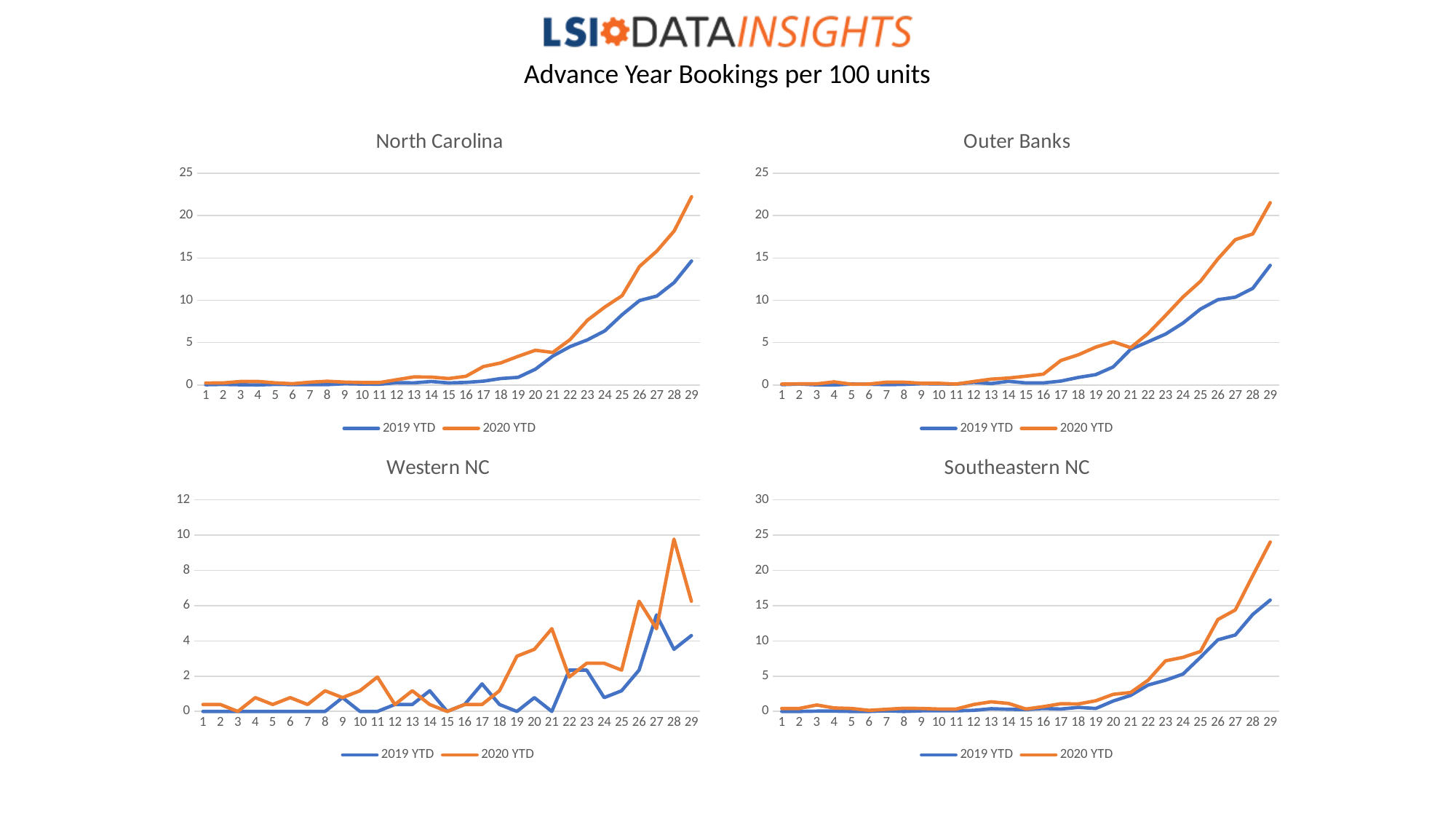
What kind of chart is the North Carolina chart? line chart How many series does the legend of the Outer Banks chart list? 2 How many points are plotted along the x axis of the Western NC chart for each series? 29 In the Southeastern NC chart, is the 2020 YTD value at point 29 greater or less than 20? greater What is the title of the chart in the bottom-right position of the slide? Southeastern NC In the Southeastern NC chart, which series is higher at point 29, 2019 YTD or 2020 YTD? 2020 YTD In the Outer Banks chart, does the 2020 YTD series generally rise or fall from point 20 to point 29? rise What is the maximum value shown on the y axis of the Western NC chart? 12 In the Western NC chart, which series is higher at point 21, 2019 YTD or 2020 YTD? 2020 YTD In the Outer Banks chart, is the 2019 YTD value at point 29 greater or less than 15? less In the North Carolina chart, is the 2020 YTD value at point 29 greater or less than 20? greater